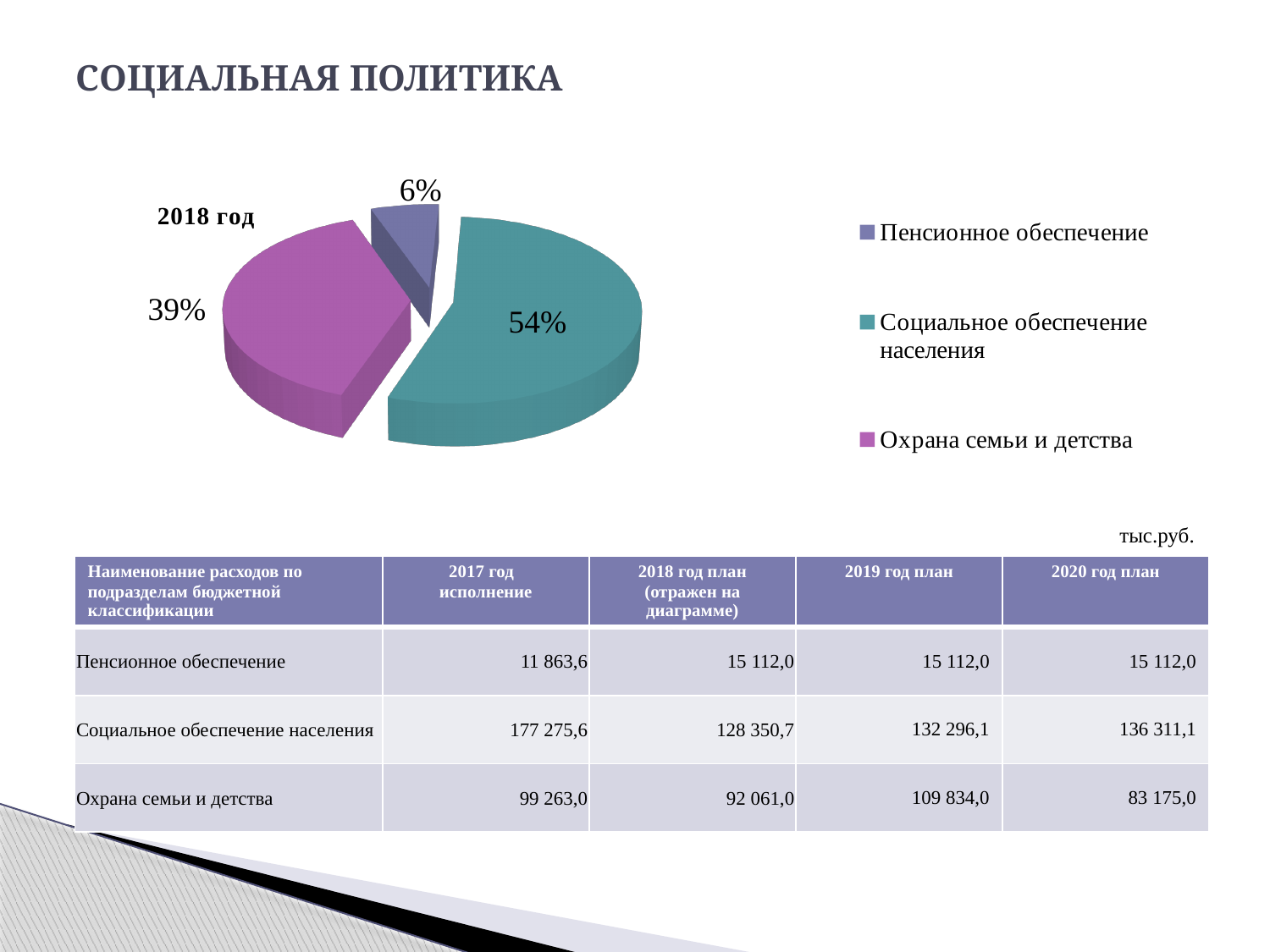
What colour is the slice for Охрана семьи и детства in the pie chart? Magenta (purple-pink) How many entries does the legend of the pie chart list? 3 What kind of chart is shown on the slide? Pie chart How many slices does the pie chart have? 3 Which category has the largest slice in the pie chart? Социальное обеспечение населения What share of the pie chart does Социальное обеспечение населения hold? 54% What share of the pie chart does Охрана семьи и детства hold? 39% What share of the pie chart does Пенсионное обеспечение hold? 6% Which category has the smallest slice in the pie chart? Пенсионное обеспечение By how many percentage points does the share of Социальное обеспечение населения exceed the share of Охрана семьи и детства? 15 percentage points Which slice is larger: Охрана семьи и детства or Пенсионное обеспечение? Охрана семьи и детства Which year is the pie chart labelled with? 2018 год